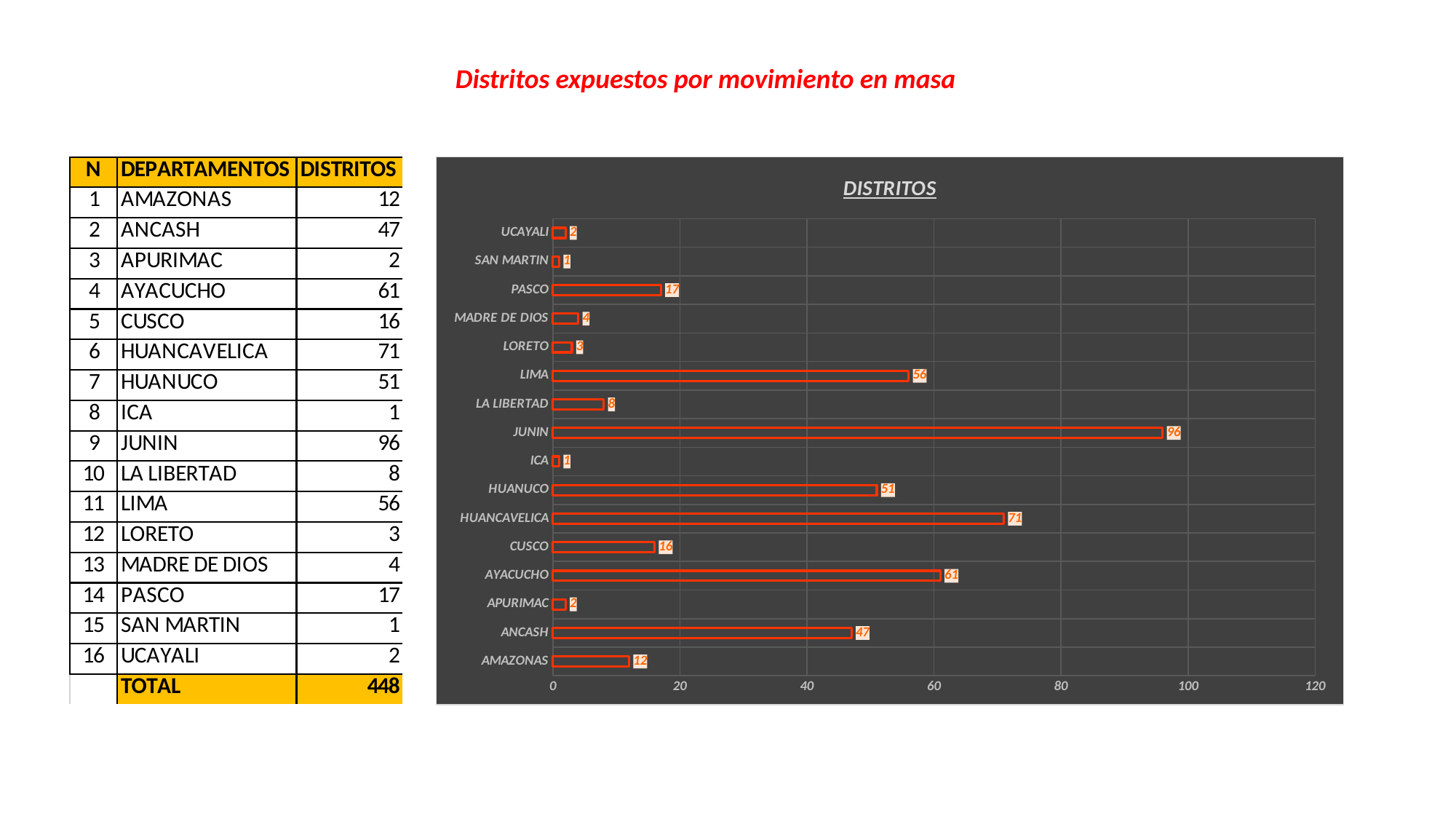
What is the difference between the values for JUNIN and AMAZONAS in the DISTRITOS chart? 84 How many departments are shown in the DISTRITOS chart? 16 Which department has the highest value in the DISTRITOS chart? JUNIN Is the value for LIMA in the DISTRITOS chart greater or less than 40? greater What kind of chart is the DISTRITOS chart? bar chart Which is larger in the DISTRITOS chart, AYACUCHO or ANCASH? AYACUCHO What is the difference between the values for HUANCAVELICA and HUANUCO in the DISTRITOS chart? 20 What is the value for LIMA in the DISTRITOS chart? 56 What is the value for JUNIN in the DISTRITOS chart? 96 What is the title of the chart? DISTRITOS What is the highest value shown on the x axis of the DISTRITOS chart? 120 What is the value for PASCO in the DISTRITOS chart? 17